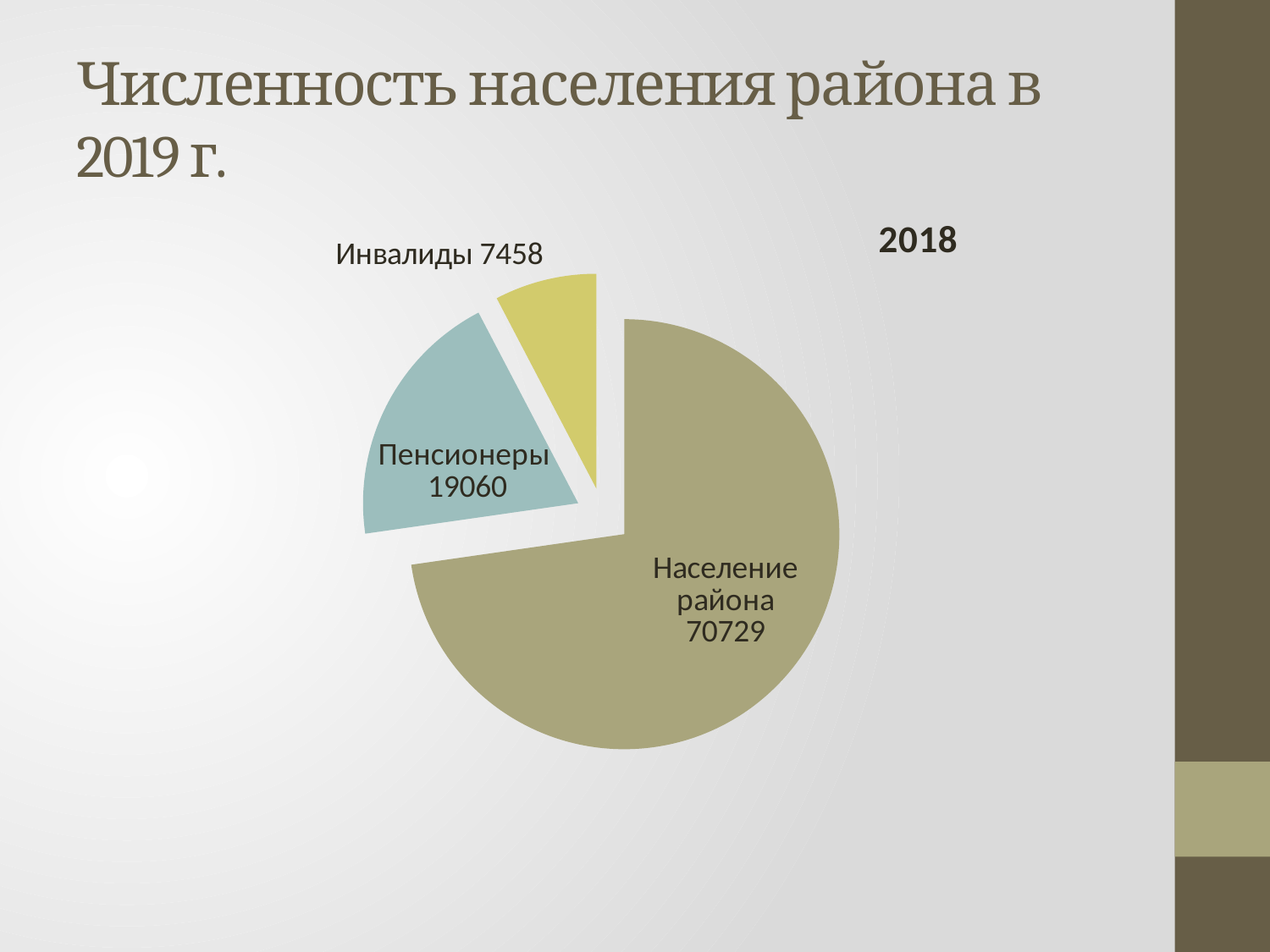
Which is larger, the value for Пенсионеры or the value for Инвалиды? Пенсионеры What is the title shown above the pie chart? 2018 Which slice of the pie chart has the largest value? Население района What is the difference between the values for Население района and Пенсионеры? 51669 What is the value for Население района in the pie chart? 70729 What is the difference between the values for Пенсионеры and Инвалиды? 11602 What colour is the Инвалиды slice in the pie chart? yellow What is the value for Пенсионеры in the pie chart? 19060 Which slice of the pie chart has the smallest value? Инвалиды What type of chart is shown on the slide? pie chart What is the value for Инвалиды in the pie chart? 7458 How many slices does the pie chart have? 3